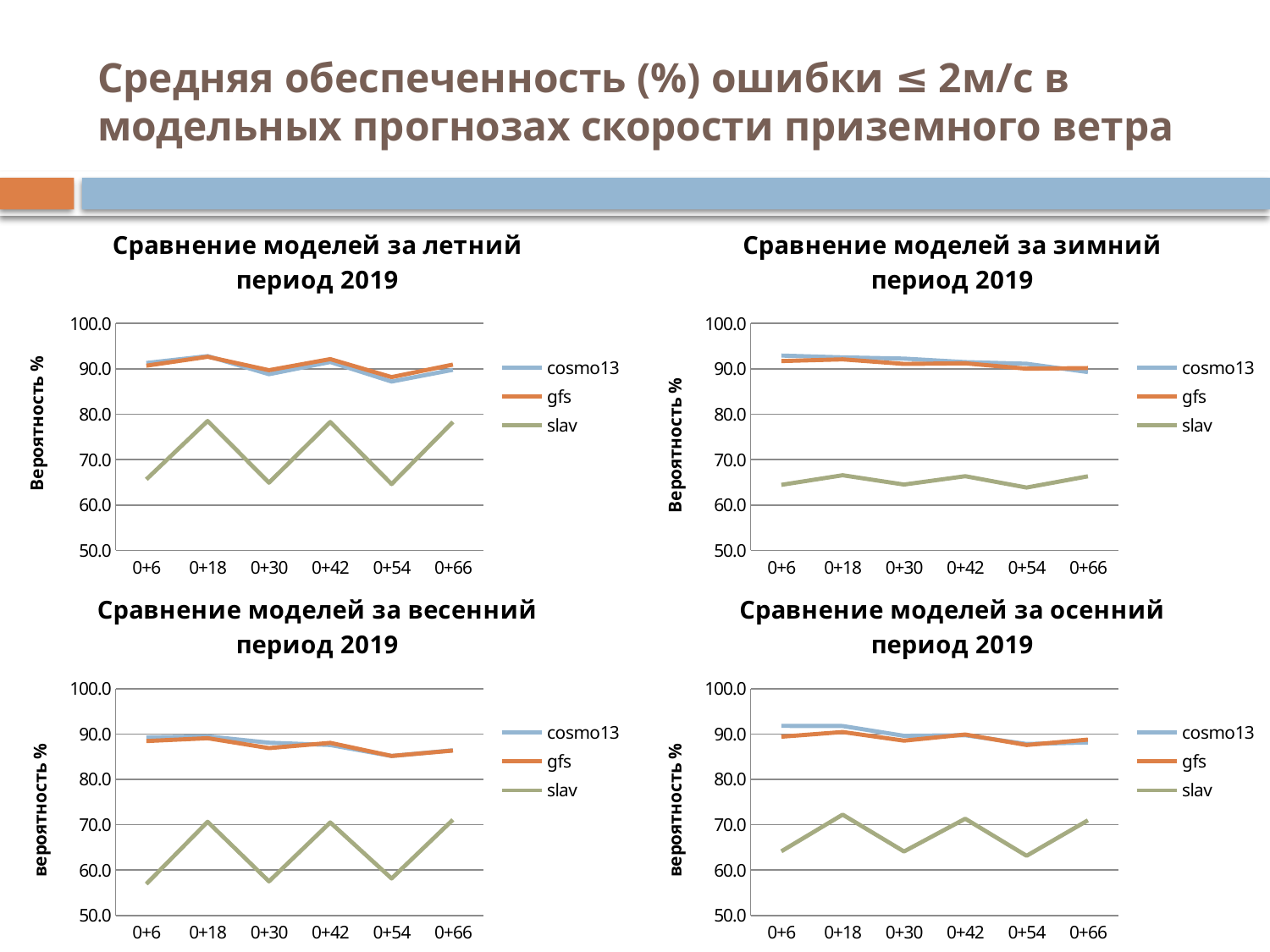
In 'Сравнение моделей за зимний период 2019', is the value for slav at 0+6 greater or less than 70.0? less In 'Сравнение моделей за зимний период 2019', does the cosmo13 line generally rise or fall from 0+6 to 0+66? fall What are the legend entries in 'Сравнение моделей за осенний период 2019'? cosmo13, gfs, slav How many points are plotted along the x axis in 'Сравнение моделей за весенний период 2019'? 6 In 'Сравнение моделей за весенний период 2019', is the value for gfs at 0+54 greater or less than 90.0? less In 'Сравнение моделей за летний период 2019', which series has the lowest value at 0+30? slav In 'Сравнение моделей за весенний период 2019', which is larger at 0+54: cosmo13 or slav? cosmo13 How many charts are shown on the slide? 4 How many series does the legend of 'Сравнение моделей за зимний период 2019' list? 3 What kind of chart is 'Сравнение моделей за летний период 2019'? line chart In 'Сравнение моделей за осенний период 2019', is the value for gfs at 0+6 greater or less than 80.0? greater